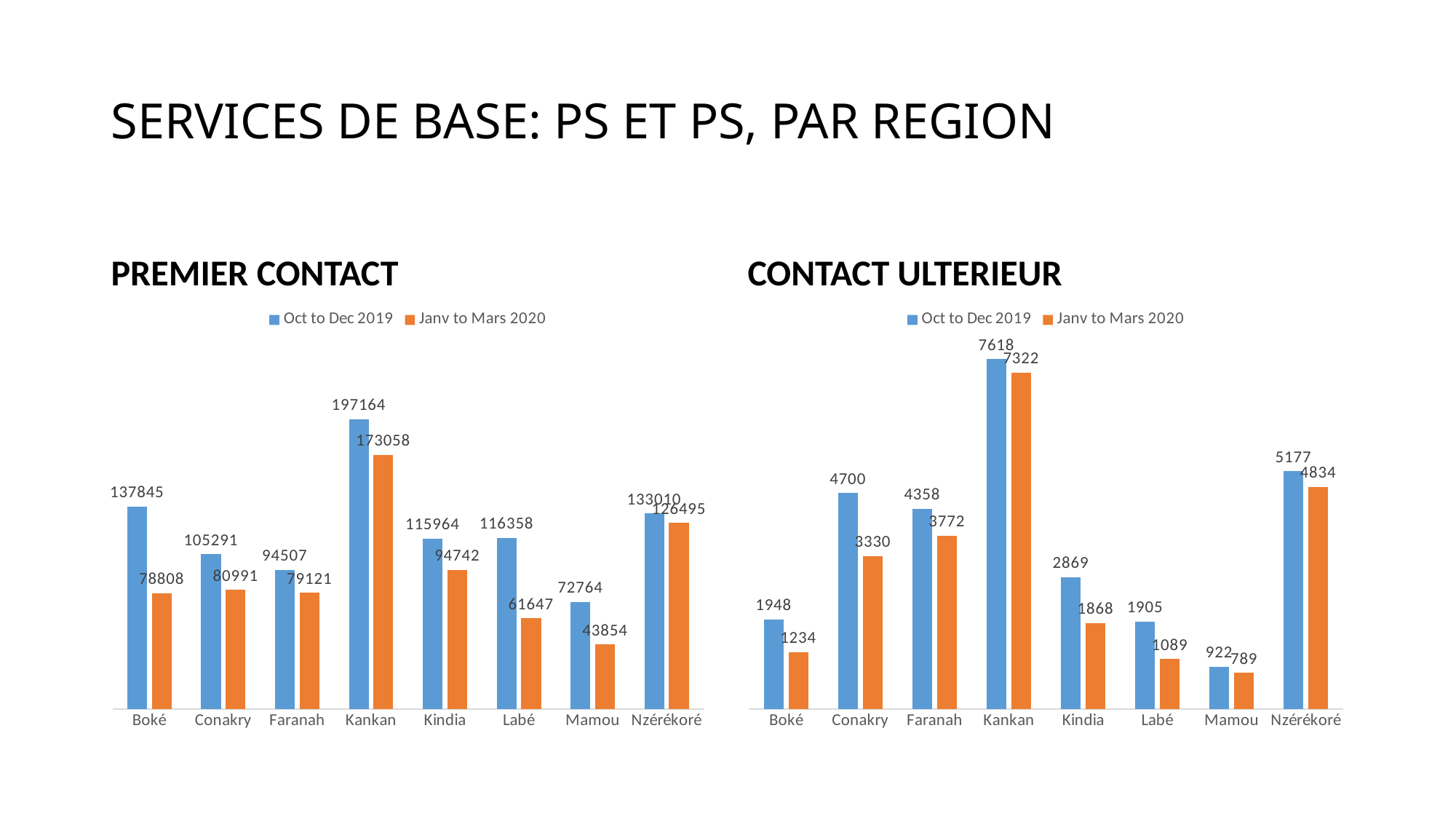
In the PREMIER CONTACT chart, what is the value for Mamou in Janv to Mars 2020? 43854 In the CONTACT ULTERIEUR chart, which region has the highest value for Oct to Dec 2019? Kankan In the CONTACT ULTERIEUR chart, which region has the lowest value for Oct to Dec 2019? Mamou In the PREMIER CONTACT chart, what is the difference between the Oct to Dec 2019 and Janv to Mars 2020 values for Labé? 54711 In the PREMIER CONTACT chart, which region has the lowest value for Janv to Mars 2020? Mamou In the PREMIER CONTACT chart, what is the value for Kankan in Oct to Dec 2019? 197164 How many regions are shown on the x axis of the CONTACT ULTERIEUR chart? 8 In the CONTACT ULTERIEUR chart, what is the difference between the Oct to Dec 2019 and Janv to Mars 2020 values for Boké? 714 How many series does the legend of the PREMIER CONTACT chart list? 2 In the CONTACT ULTERIEUR chart, what is the value for Faranah in Janv to Mars 2020? 3772 In the PREMIER CONTACT chart, which is larger for Oct to Dec 2019: Boké or Nzérékoré? Boké What type of chart is the CONTACT ULTERIEUR chart? Bar chart